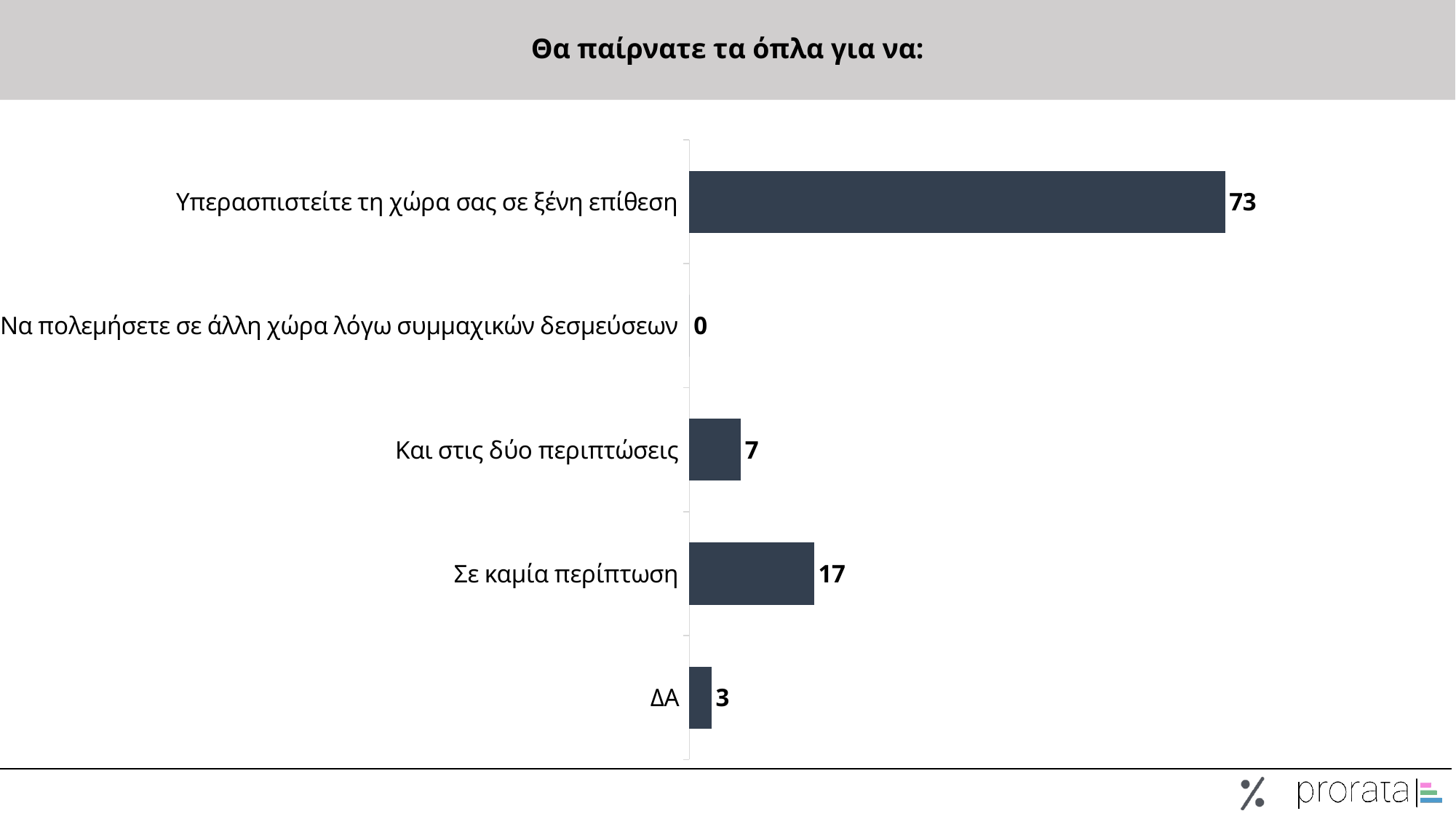
What is the title of the chart? Θα παίρνατε τα όπλα για να: What is the value for 'Σε καμία περίπτωση'? 17 Which category has the highest value? Υπερασπιστείτε τη χώρα σας σε ξένη επίθεση What kind of chart is shown on the slide? Bar chart What is the value for 'Και στις δύο περιπτώσεις'? 7 What is the difference between the values for 'Υπερασπιστείτε τη χώρα σας σε ξένη επίθεση' and 'Σε καμία περίπτωση'? 56 How many categories are shown in the chart? 5 Which category has the lowest value? Να πολεμήσετε σε άλλη χώρα λόγω συμμαχικών δεσμεύσεων What is the value for 'Υπερασπιστείτε τη χώρα σας σε ξένη επίθεση'? 73 What is the value for 'Να πολεμήσετε σε άλλη χώρα λόγω συμμαχικών δεσμεύσεων'? 0 Which is larger: the value for 'Σε καμία περίπτωση' or the value for 'Και στις δύο περιπτώσεις'? Σε καμία περίπτωση What is the value for 'ΔΑ'? 3